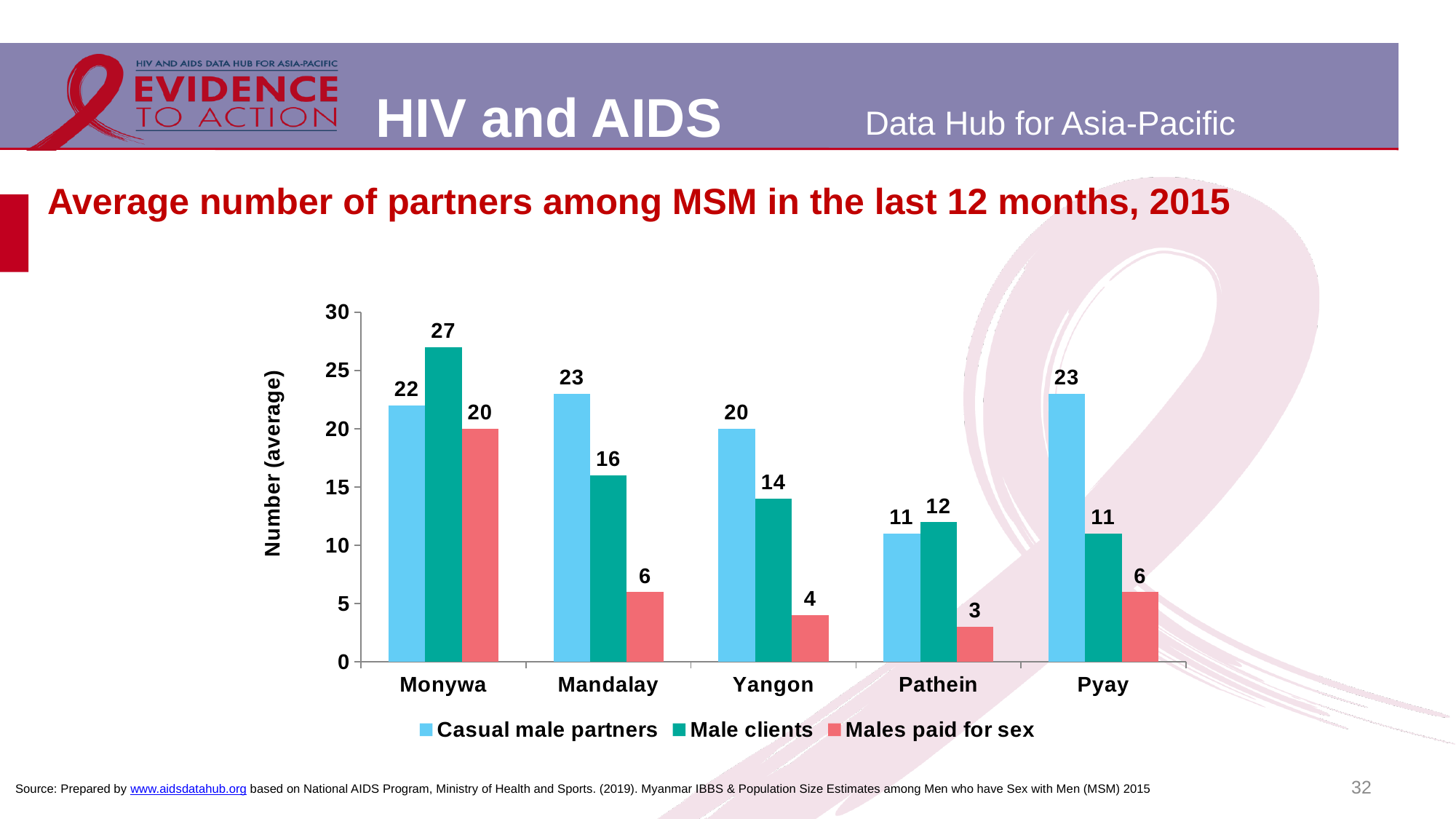
What is the average number of casual male partners in Monywa? 22 What kind of chart is shown on the slide? Bar chart What is the average number of males paid for sex in Pathein? 3 How many cities are shown on the x axis? 5 What is the label of the vertical axis? Number (average) Which city has the highest average number of male clients? Monywa What is the difference between the average number of casual male partners and male clients in Pyay? 12 Which is larger in Yangon: the average number of casual male partners or male clients? Casual male partners Is the value for males paid for sex in Monywa greater or less than 15? greater What is the average number of male clients in Mandalay? 16 How many series does the legend list? 3 Which city has the lowest average number of casual male partners? Pathein